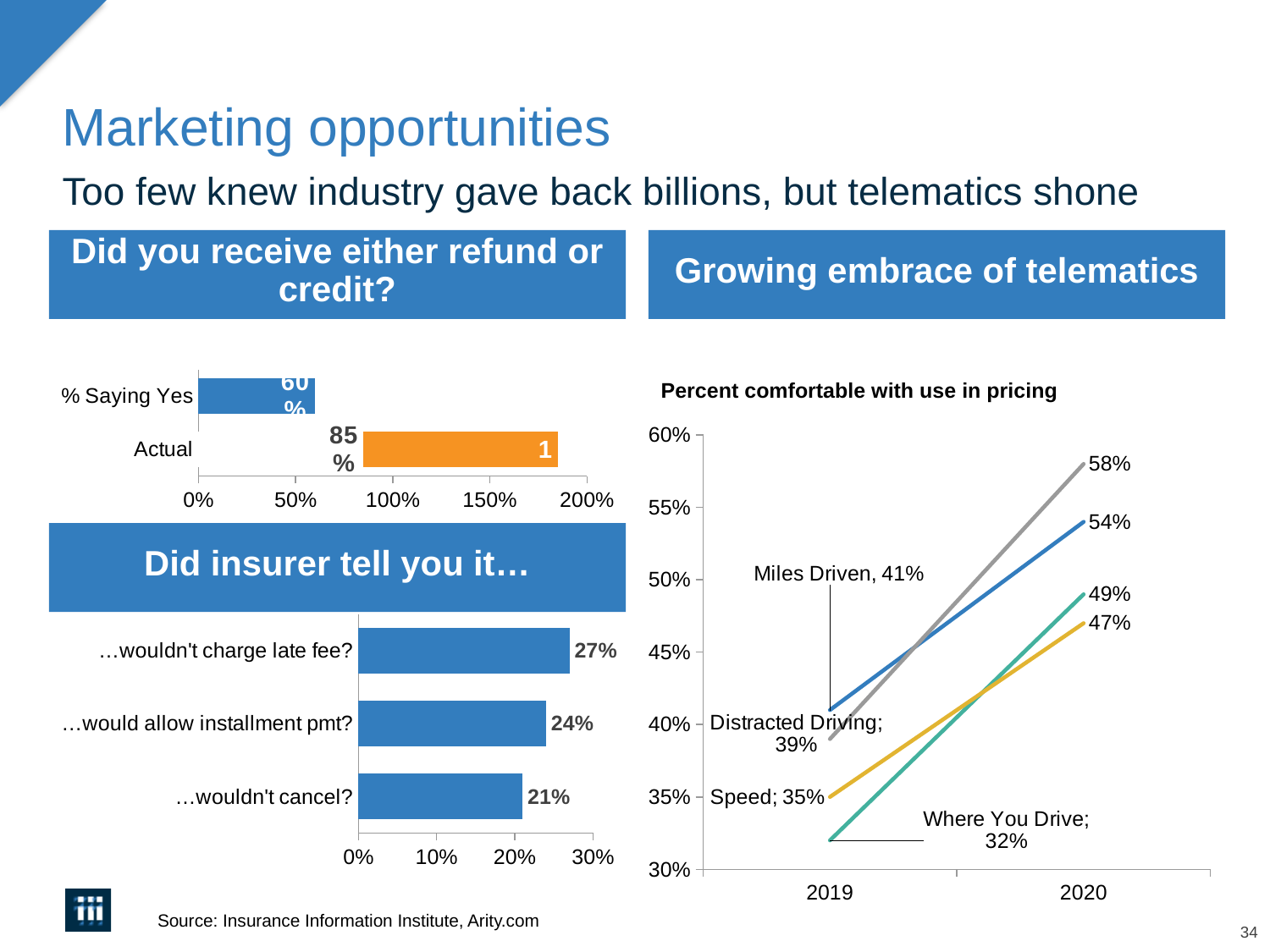
In the 'Growing embrace of telematics' chart, what was the percent comfortable with use of Miles Driven in pricing in 2019? 41% How many categories are shown in the 'Did insurer tell you it…' chart? 3 In the 'Did insurer tell you it…' chart, what is the difference between '…wouldn't charge late fee?' and '…would allow installment pmt?' 3% In the 'Did insurer tell you it…' chart, what percentage is shown for '…wouldn't charge late fee?' 27% In the 'Did you receive either refund or credit?' chart, is the '% Saying Yes' bar greater or less than 50%? greater In the 'Growing embrace of telematics' chart, which factor had the lowest percent comfortable in 2019? Where You Drive In the 'Growing embrace of telematics' chart, do the values rise or fall from 2019 to 2020? Rise In the 'Did insurer tell you it…' chart, what percentage is shown for '…wouldn't cancel?' 21% In the 'Did insurer tell you it…' chart, which category has the lowest value? …wouldn't cancel? What kind of chart is the 'Did insurer tell you it…' chart? Bar chart In the 'Growing embrace of telematics' chart, what was the 2019 value for Where You Drive? 32% In the 'Growing embrace of telematics' chart, what is the highest value shown for 2020? 58%